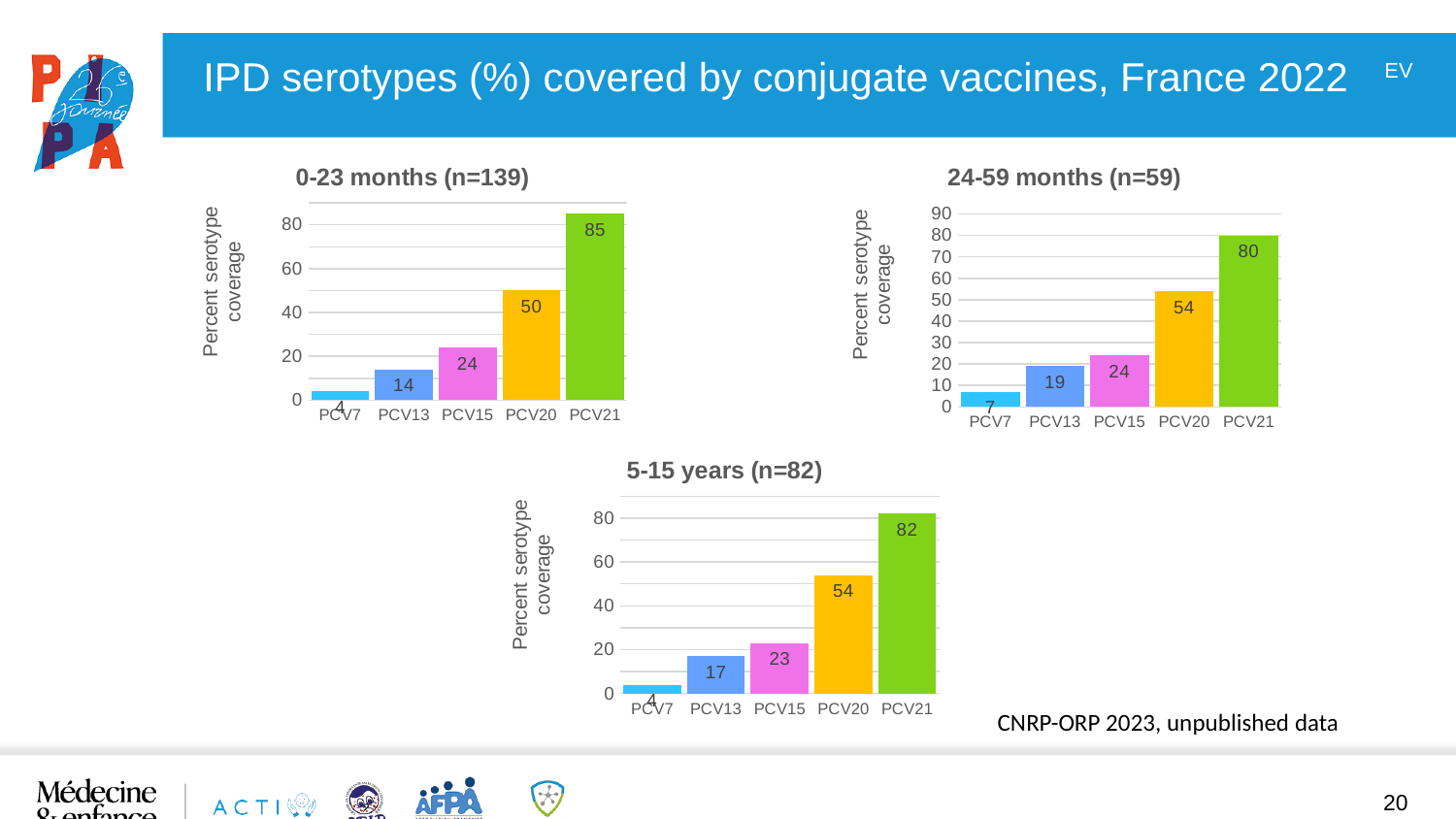
In the '0-23 months (n=139)' chart, what is the difference in percent serotype coverage between PCV15 and PCV13? 10 In the '0-23 months (n=139)' chart, which vaccine has the highest percent serotype coverage? PCV21 In the '5-15 years (n=82)' chart, what is the percent serotype coverage for PCV15? 23 How many vaccine categories are shown in the '5-15 years (n=82)' chart? 5 In the '24-59 months (n=59)' chart, which has higher percent serotype coverage, PCV20 or PCV15? PCV20 What is the y-axis label of the '5-15 years (n=82)' chart? Percent serotype coverage In the '24-59 months (n=59)' chart, what is the percent serotype coverage for PCV13? 19 In the '0-23 months (n=139)' chart, what is the percent serotype coverage for PCV20? 50 In the '5-15 years (n=82)' chart, what is the difference in percent serotype coverage between PCV21 and PCV20? 28 In the '24-59 months (n=59)' chart, which vaccine has the lowest percent serotype coverage? PCV7 In the '0-23 months (n=139)' chart, do the values rise or fall from PCV7 to PCV21? Rise What type of chart is the '24-59 months (n=59)' chart? Bar chart